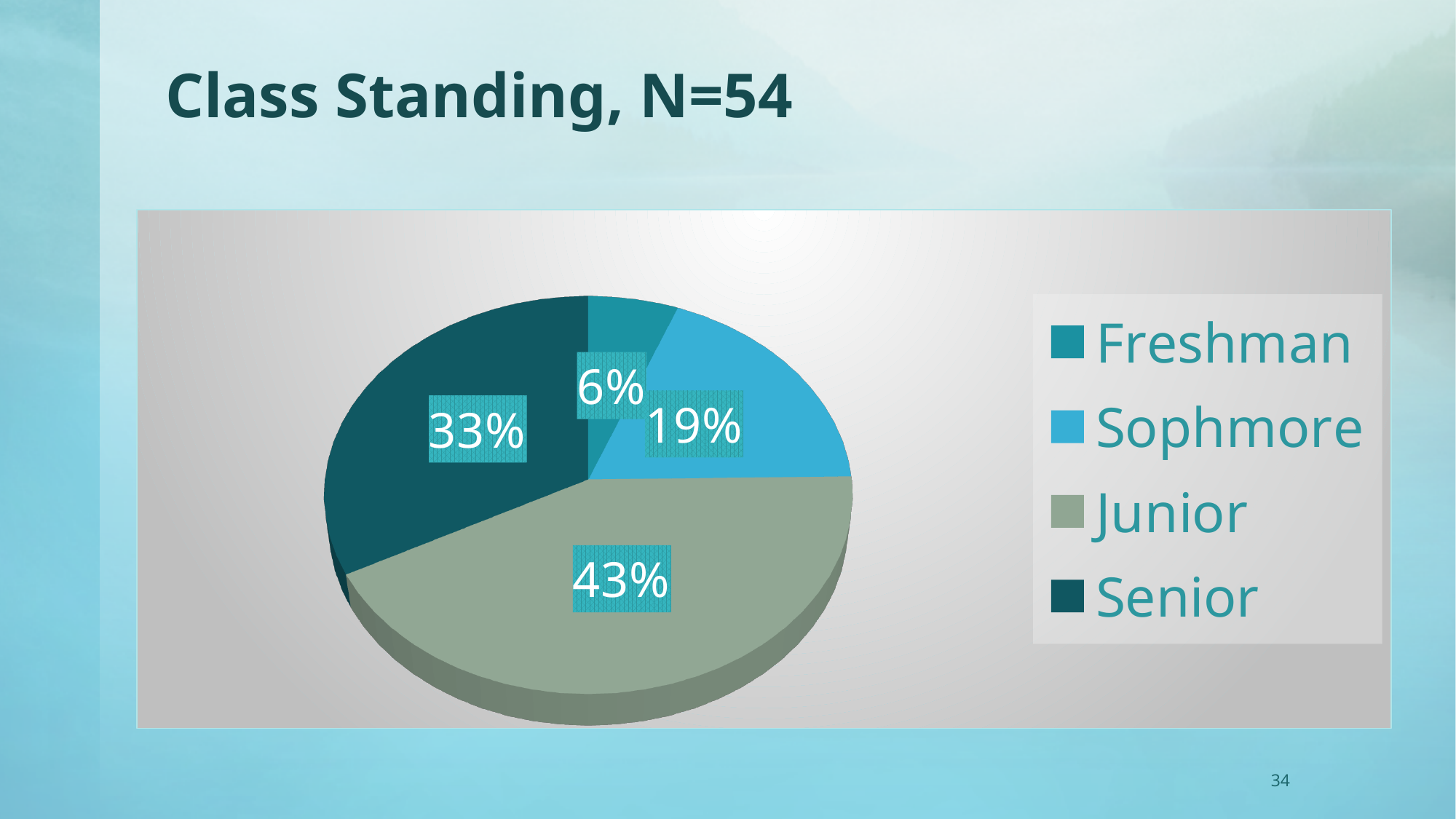
What share of the pie does Junior represent? 43% Which class standing has the largest slice of the pie? Junior How many categories are shown in the pie chart? 4 What share of the pie does Sophmore represent? 19% What is the difference in percentage points between the Sophmore and Freshman slices? 13 What is the title of the chart on the slide? Class Standing, N=54 Which slice is larger, Senior or Sophmore? Senior What is the difference in percentage points between the Junior and Senior slices? 10 Which class standing has the smallest slice of the pie? Freshman What share of the pie does Senior represent? 33% What kind of chart is shown on the slide? Pie chart